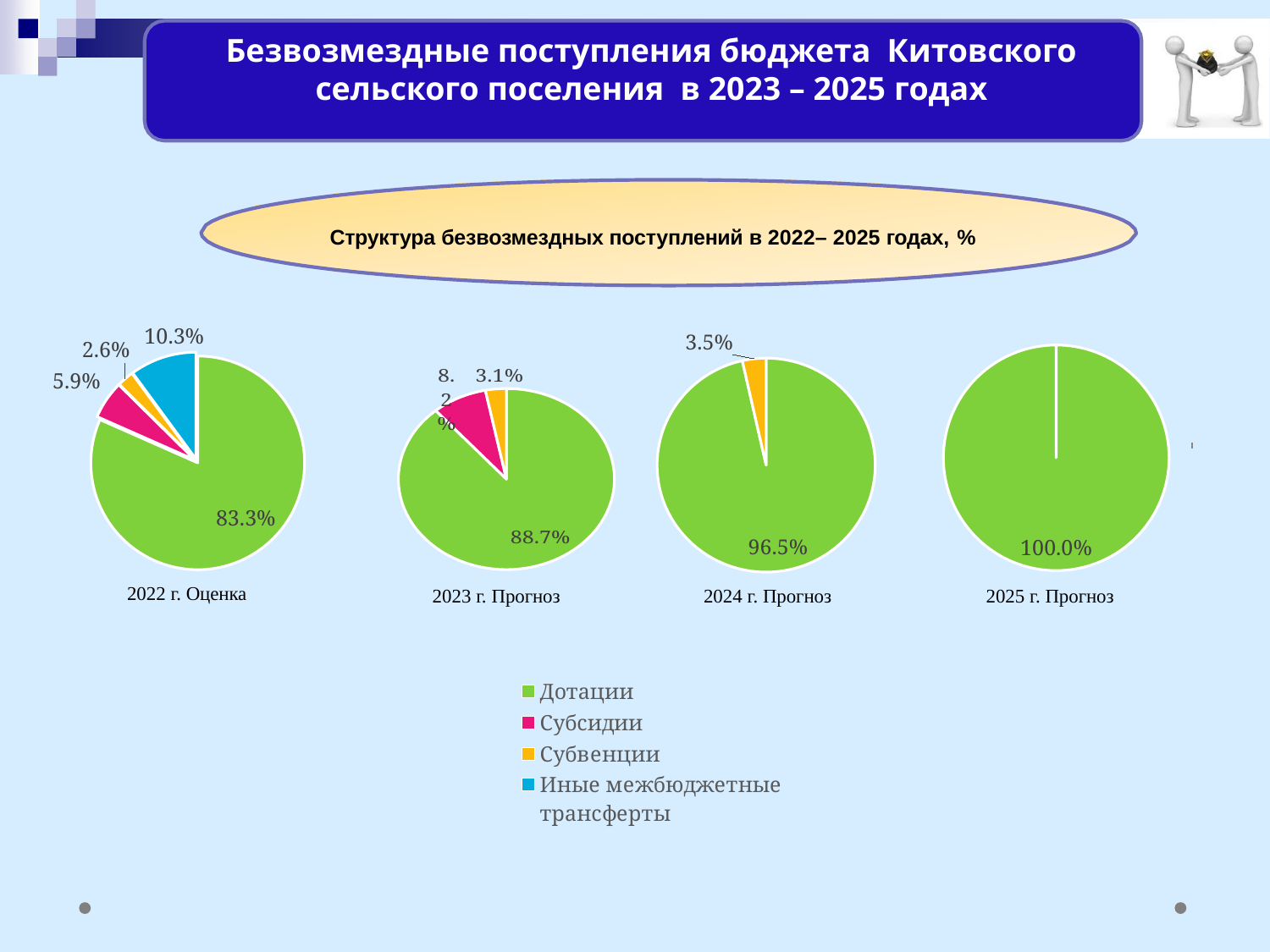
What is the difference between the Дотации share in the 2024 г. Прогноз chart and in the 2023 г. Прогноз chart? 7.8% In the 2025 г. Прогноз pie chart, what is the share of Дотации? 100.0% In the 2022 г. Оценка pie chart, what is the share of Субвенции? 2.6% In the 2022 г. Оценка pie chart, what is the share of Субсидии? 5.9% In the 2022 г. Оценка pie chart, what is the share of Иные межбюджетные трансферты? 10.3% How many pie charts are on the slide? 4 What kind of charts are shown on the slide? Pie charts In the 2023 г. Прогноз pie chart, what is the share of Дотации? 88.7% In the 2022 г. Оценка pie chart, which category has the smallest slice? Субвенции In the 2024 г. Прогноз pie chart, what is the share of Субвенции? 3.5% In the 2022 г. Оценка pie chart, what is the share of Дотации? 83.3% How many entries does the legend list? 4